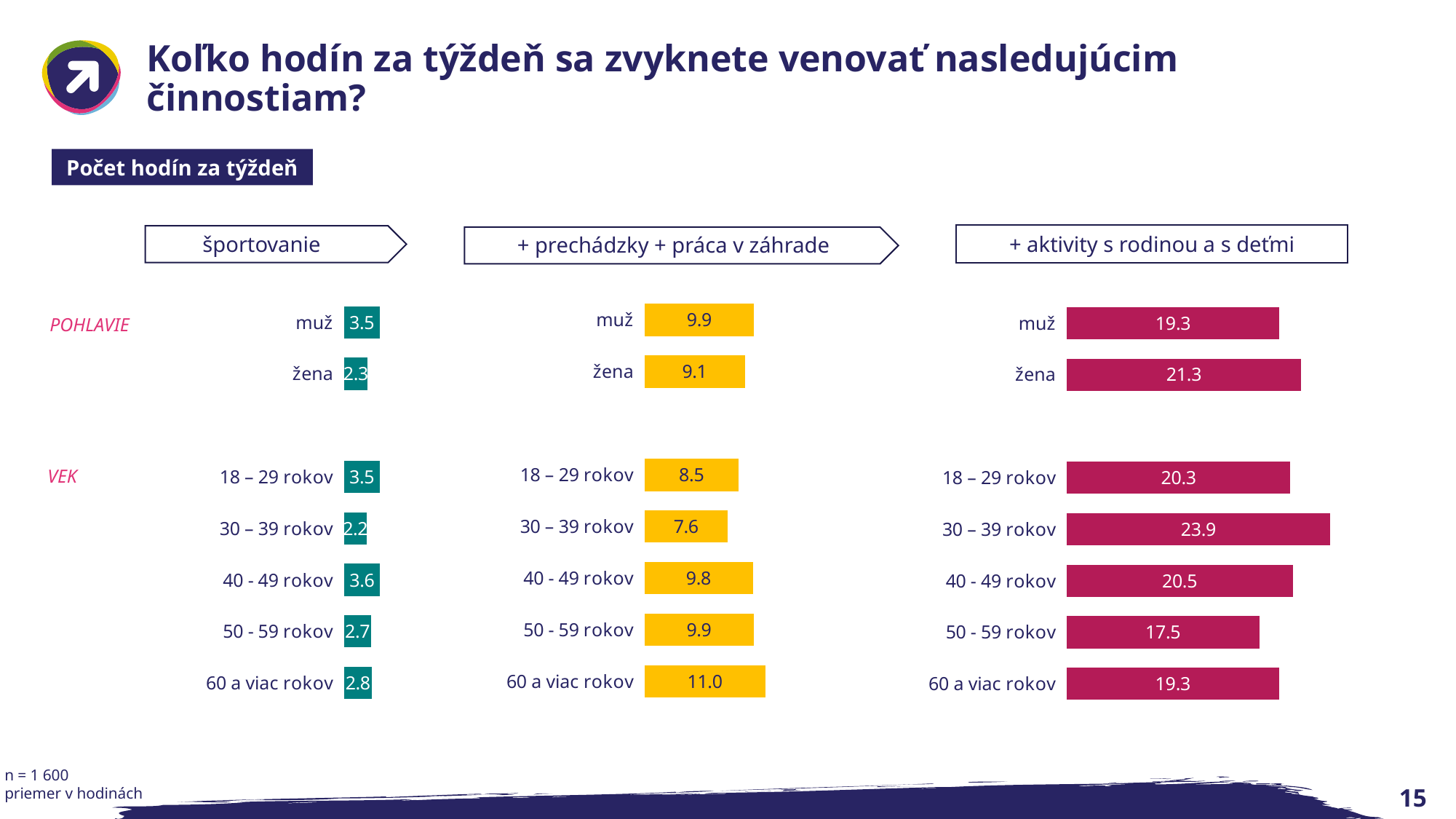
In the "+ aktivity s rodinou a s deťmi" chart, what is the difference between the values for žena and muž? 2.0 In the "športovanie" chart, what is the difference between the values for 40 - 49 rokov and 30 – 39 rokov? 1.4 In the "+ aktivity s rodinou a s deťmi" chart, which age group has the highest value? 30 – 39 rokov In the "+ prechádzky + práca v záhrade" chart, which age group has the lowest value? 30 – 39 rokov In the "+ prechádzky + práca v záhrade" chart, what is the value for 60 a viac rokov? 11.0 In the "+ aktivity s rodinou a s deťmi" chart, what is the value for žena? 21.3 In the "+ prechádzky + práca v záhrade" chart, which is larger, the value for muž or the value for žena? muž In the "+ aktivity s rodinou a s deťmi" chart, which age group has the lowest value? 50 - 59 rokov What kind of chart is used in the "+ aktivity s rodinou a s deťmi" section? bar chart In the "športovanie" chart, what is the value for muž? 3.5 How many age groups are shown in the "športovanie" chart? 5 What colour are the bars in the "+ prechádzky + práca v záhrade" chart? yellow